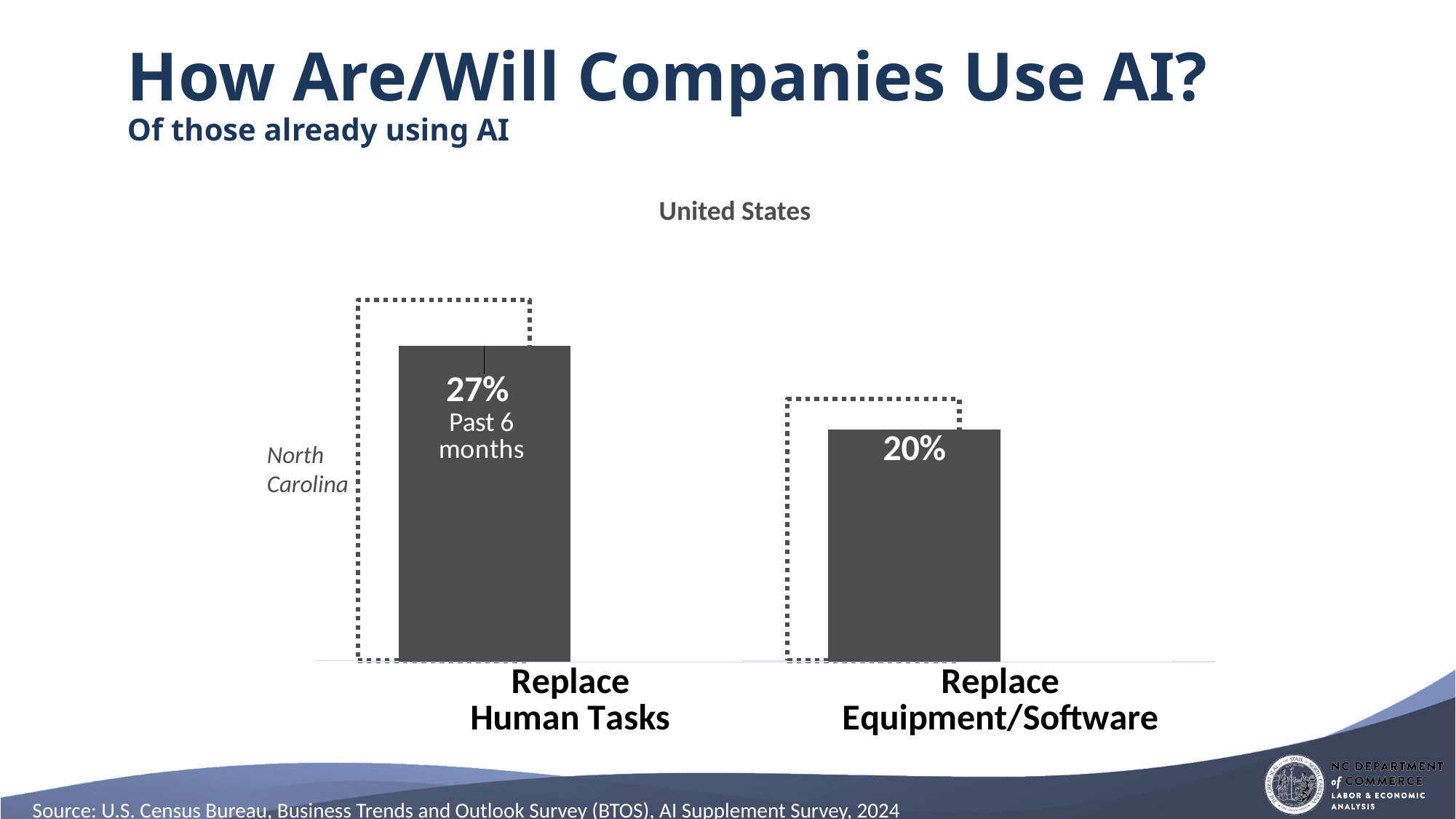
Is the dotted North Carolina outline for Replace Human Tasks taller or shorter than the solid United States bar? Taller What is the value for Replace Equipment/Software in the United States chart? 20% What is the difference between the United States values for Replace Human Tasks and Replace Equipment/Software? 7% What do the dotted outlines around the bars represent, according to the label on the slide? North Carolina Which category has the lowest value among the solid United States bars? Replace Equipment/Software What kind of chart is shown on the slide? Bar chart Which category has the highest value among the solid United States bars? Replace Human Tasks Which is larger for the United States: Replace Human Tasks or Replace Equipment/Software? Replace Human Tasks What is the title printed above the chart? United States What is the value for Replace Human Tasks in the United States chart? 27% How many categories are shown on the x axis of the chart? 2 What time period is noted inside the Replace Human Tasks bar? Past 6 months